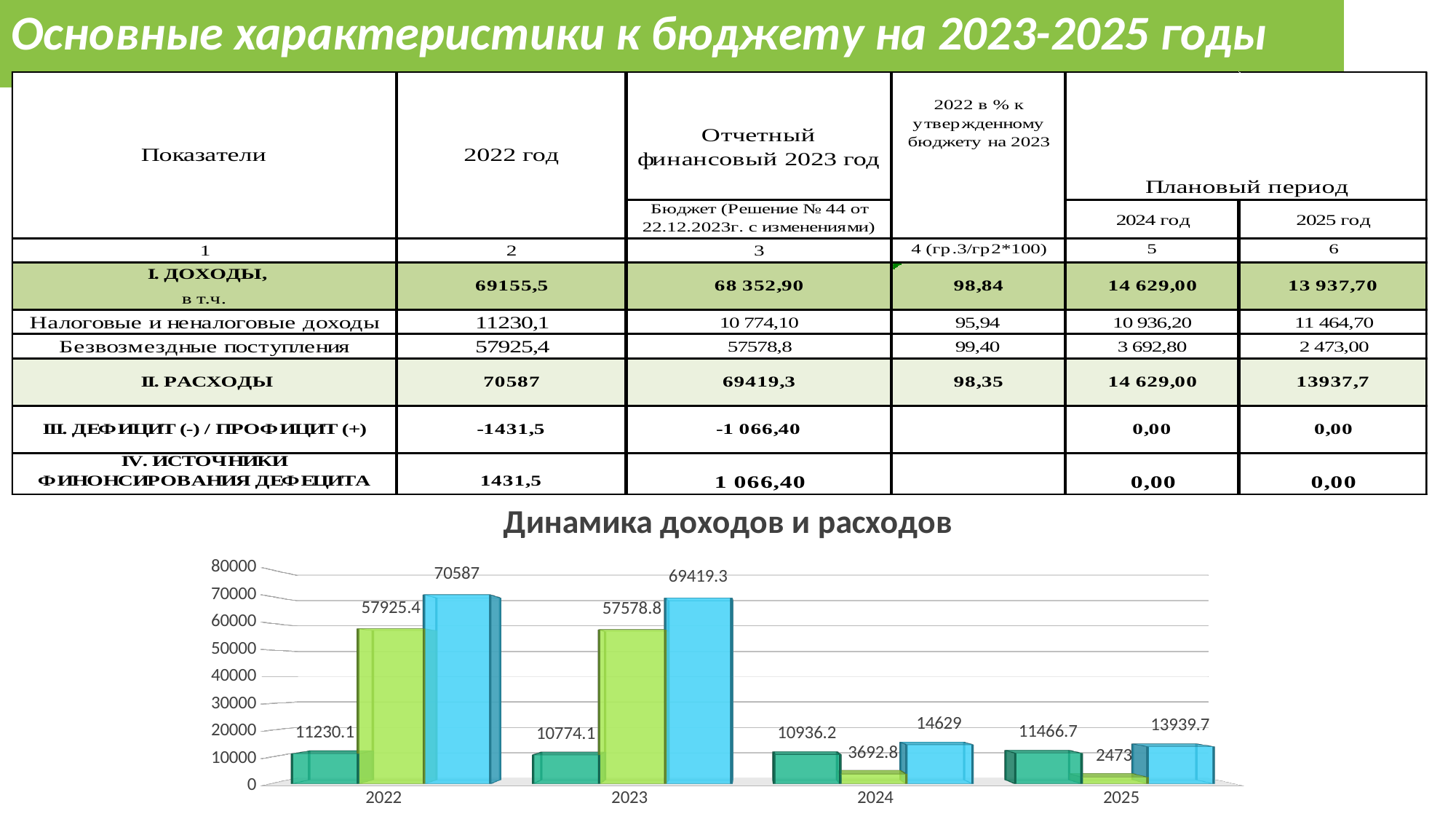
In the chart "Динамика доходов и расходов", is the dark green bar for 2024 larger or smaller than the light green bar for 2024? larger In the chart "Динамика доходов и расходов", do the blue bar values rise or fall from 2022 to 2025? fall In the chart "Динамика доходов и расходов", what is the value of the light green bar for 2023? 57578.8 In the chart "Динамика доходов и расходов", which year has the highest blue bar? 2022 How many years are shown on the x axis of the chart "Динамика доходов и расходов"? 4 In the chart "Динамика доходов и расходов", is the blue bar for 2025 greater or less than 20000? less In the chart "Динамика доходов и расходов", what is the value of the blue bar for 2022? 70587 In the chart "Динамика доходов и расходов", what is the difference between the blue bar values for 2022 and 2023? 1167.7 What type of chart is shown under the title "Динамика доходов и расходов"? bar chart In the chart "Динамика доходов и расходов", what is the value of the light green bar for 2024? 3692.8 In the chart "Динамика доходов и расходов", what is the value of the dark green bar for 2025? 11466.7 In the chart "Динамика доходов и расходов", which year has the lowest light green bar? 2025